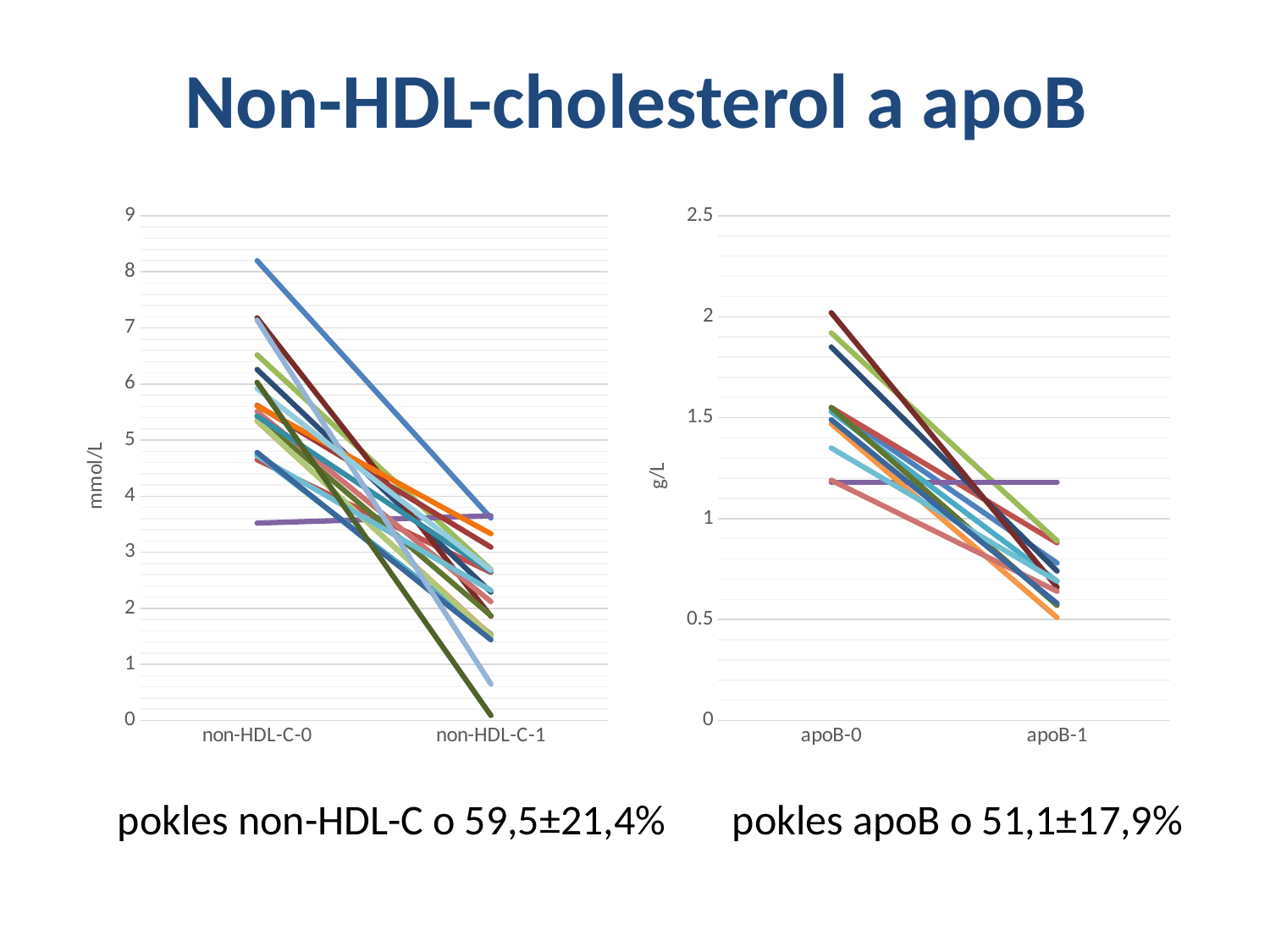
How many categories are on the x axis of the right chart (apoB)? 2 In the right chart (apoB), is the highest value at apoB-1 greater or less than 1? greater What is the y-axis unit label on the left chart (non-HDL-C)? mmol/L In the right chart (apoB), is the lowest value at apoB-0 greater or less than 1? greater In the right chart (apoB), do most lines rise or fall from apoB-0 to apoB-1? fall What is the y-axis unit label on the right chart (apoB)? g/L What kind of chart is the right chart (apoB)? line chart In the left chart (non-HDL-C), do most lines rise or fall from non-HDL-C-0 to non-HDL-C-1? fall In the left chart (non-HDL-C), is the lowest value at non-HDL-C-1 greater or less than 1? less How many categories are on the x axis of the left chart (non-HDL-C)? 2 What kind of chart is the left chart (non-HDL-C)? line chart